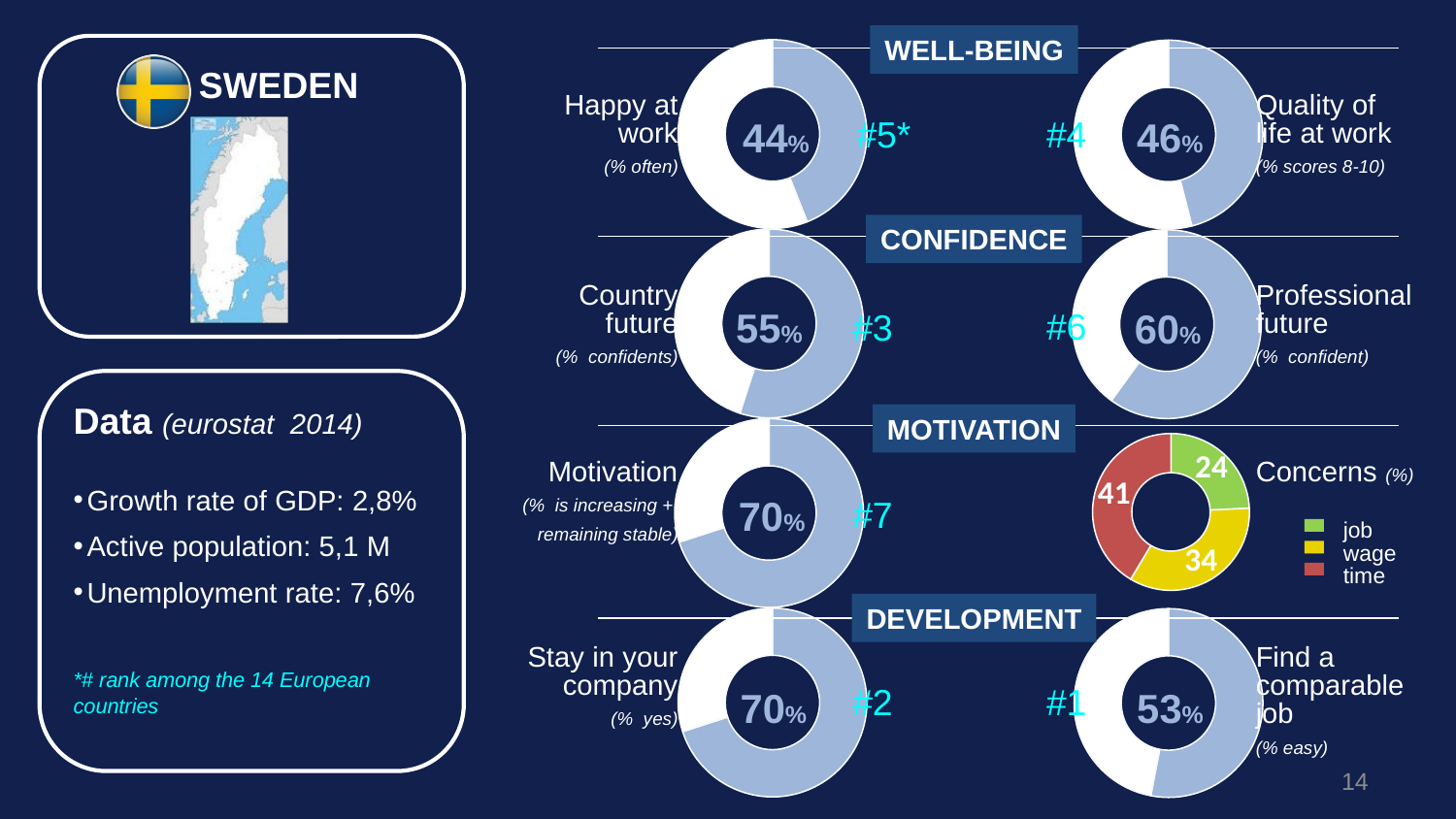
What is the difference between the 'Stay in your company' percentage and the 'Find a comparable job' percentage? 17% On the 'Concerns' pie chart, which category has the largest value? time On the 'Concerns' pie chart, what is the difference between the 'time' value and the 'job' value? 17 Which is larger: the percentage on the 'Professional future' donut chart or the percentage on the 'Country future' donut chart? Professional future On the 'Concerns' pie chart, which category has the smallest value? job On the 'Country future' donut chart, what percentage of respondents are confident? 55% On the 'Professional future' donut chart, what percentage is shown? 60% On the 'Happy at work' donut chart, what percentage is shown in the centre? 44% On the 'Quality of life at work' donut chart, what percentage is shown? 46% How many categories does the legend of the 'Concerns' pie chart list? 3 On the 'Find a comparable job' donut chart, what percentage is shown? 53% On the 'Concerns' pie chart, what is the value for 'wage'? 34